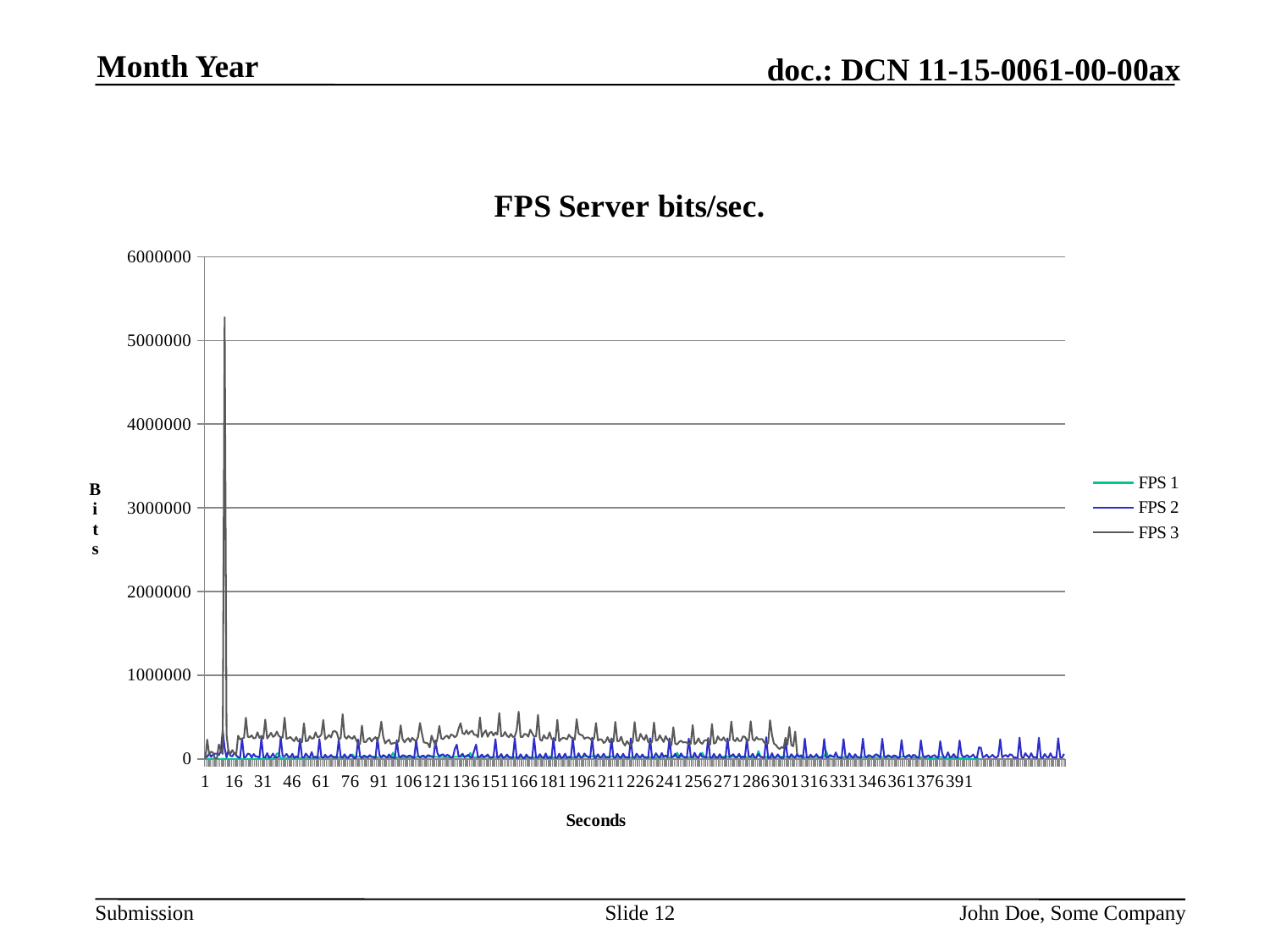
Is the peak value of the FPS 3 series greater or less than 6000000? less What is the title of the chart? FPS Server bits/sec. Which series has the larger peak value, FPS 2 or FPS 3? FPS 3 What kind of chart is shown on the slide? line chart Which series reaches the highest peak value on the chart? FPS 3 Does the FPS 3 series generally rise or fall along the x axis after its early spike? fall Is the peak value of the FPS 2 series greater or less than 1000000? less What is the highest value shown on the y axis? 6000000 Is the peak value of the FPS 3 series greater or less than 5000000? greater What is the label of the x axis? Seconds How many series does the legend list? 3